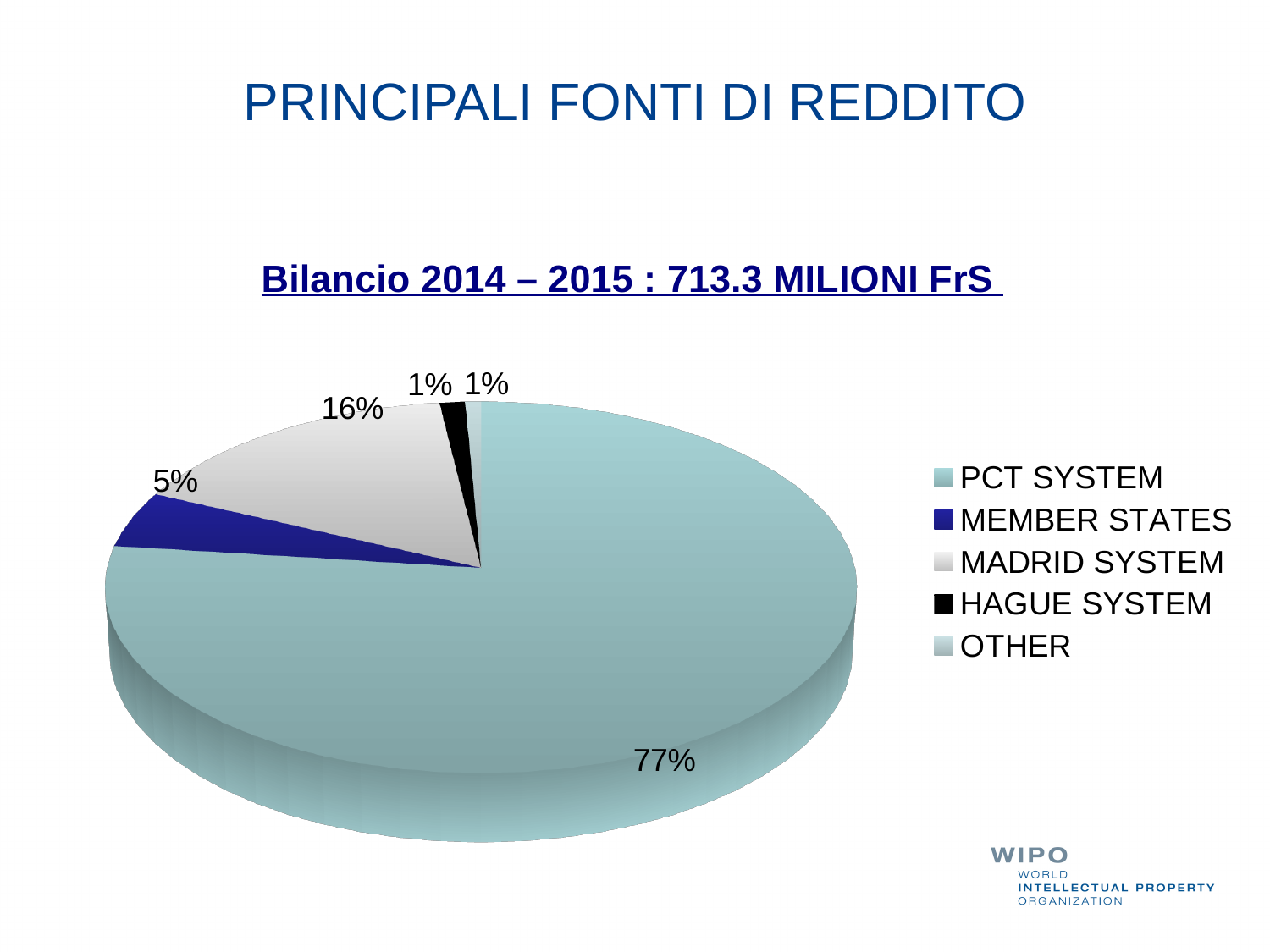
What share of the pie does HAGUE SYSTEM account for? 1% What share of the pie does PCT SYSTEM account for? 77% How many entries does the legend list? 5 What is the combined share of MADRID SYSTEM and MEMBER STATES? 21% Which slice is larger, MADRID SYSTEM or MEMBER STATES? MADRID SYSTEM What share of the pie does MADRID SYSTEM account for? 16% How many slices does the pie chart have? 5 What is the difference in percentage points between the PCT SYSTEM slice and the MADRID SYSTEM slice? 61 What total budget figure is stated in the subtitle above the chart? 713.3 MILIONI FrS What kind of chart is shown on the slide? pie chart Which category has the largest slice of the pie? PCT SYSTEM